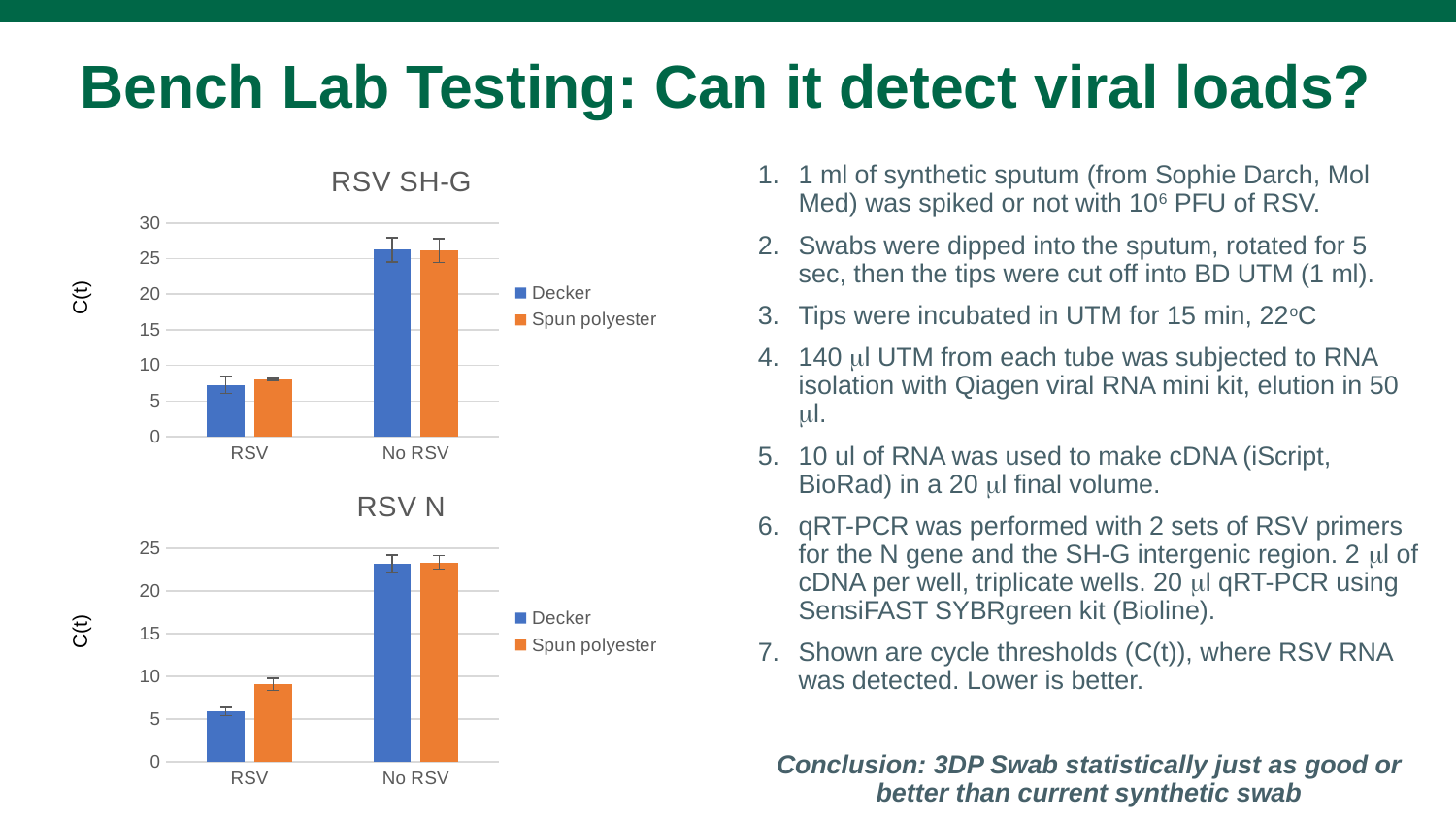
In the RSV SH-G chart, which category has the higher Decker value? No RSV In the RSV SH-G chart, is the Decker value for RSV greater or less than 10? less In the RSV N chart, which series has the larger value for RSV, Decker or Spun polyester? Spun polyester In the RSV N chart, is the Decker value for RSV greater or less than 10? less How many series does the legend of the RSV N chart list? 2 How many categories are shown on the x axis of the RSV SH-G chart? 2 In the RSV N chart, is the Spun polyester value for No RSV greater or less than 20? greater In the RSV SH-G chart, which series is shown in orange? Spun polyester What kind of chart is the RSV SH-G chart? bar chart In the RSV N chart, which category has the lowest Decker value? RSV What is the y-axis label of the RSV N chart? C(t)